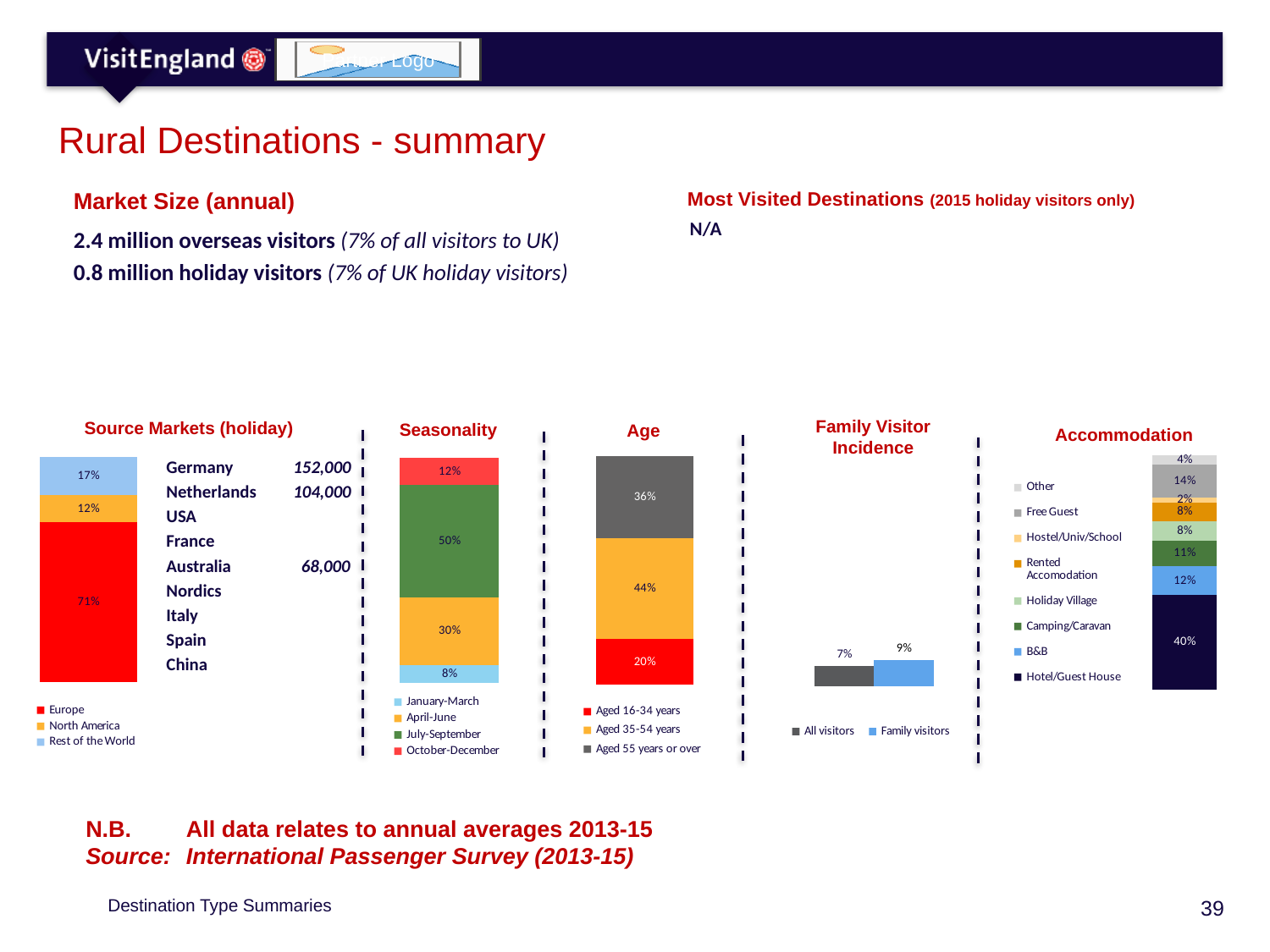
In the Family Visitor Incidence chart, which is larger: All visitors or Family visitors? Family visitors In the Seasonality chart, what is the difference between the April-June and October-December shares? 18% In the Family Visitor Incidence chart, what is the value for Family visitors? 9% In the Accommodation chart, what share of visitors stay in a Hotel/Guest House? 40% In the Seasonality chart, which period has the lowest share of visits? January-March In the Accommodation chart, what share stay in B&B? 12% In the Age chart, which age group has the largest share? Aged 35-54 years In the Age chart, what percentage of visitors are aged 16-34 years? 20% In the Source Markets (holiday) chart, what share comes from Rest of the World? 17% In the Seasonality chart, what percentage of visits occur in July-September? 50% How many series does the legend of the Accommodation chart list? 8 In the Source Markets (holiday) chart, what share of holiday visitors comes from Europe? 71%